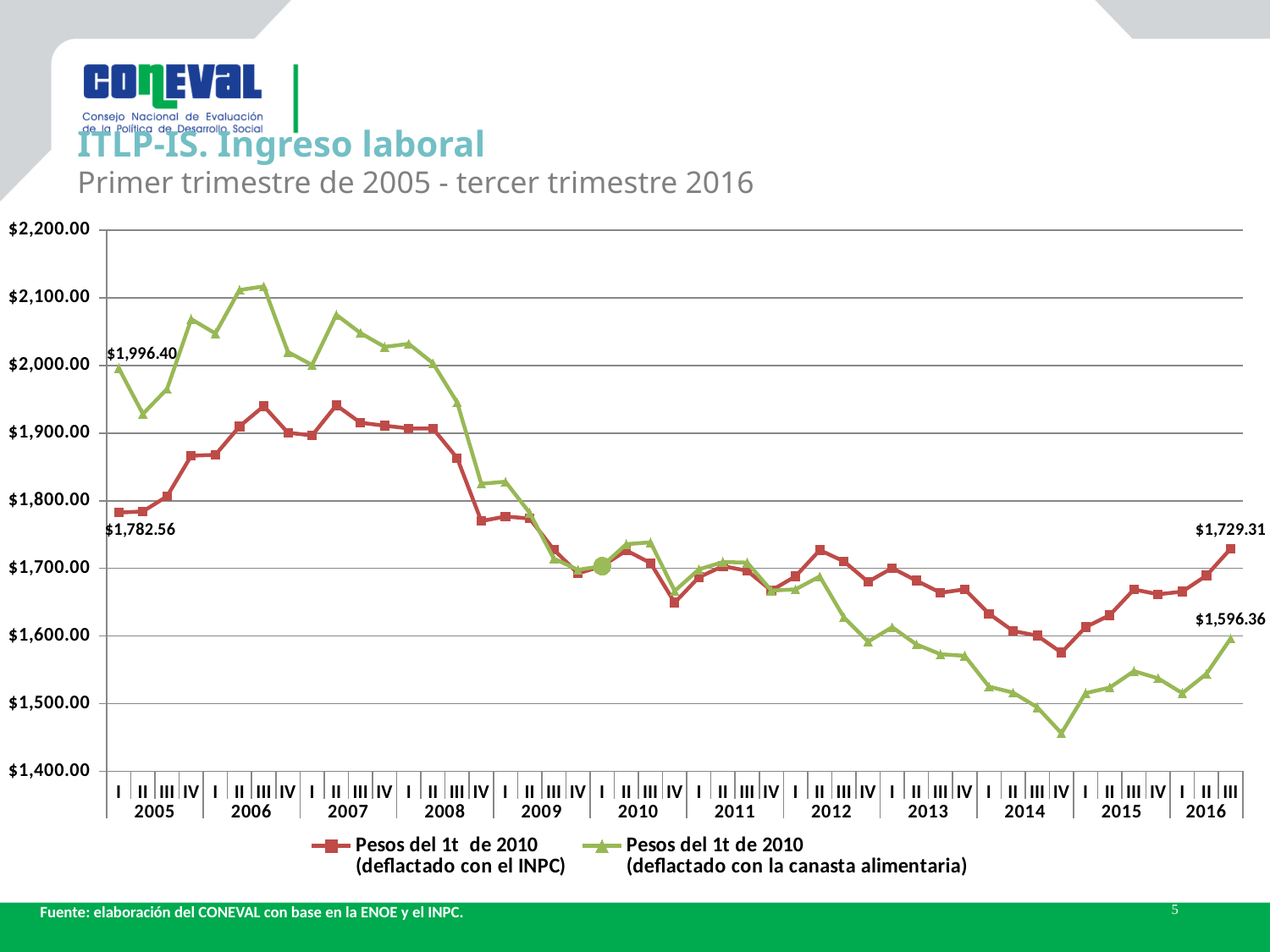
What is the difference between the two series' labelled values in the third quarter of 2016? $132.95 What is the value of the series deflated with the INPC in the third quarter of 2016? $1,729.31 How many series does the legend list? 2 Which series has the higher value in the third quarter of 2016? Pesos del 1t de 2010 (deflactado con el INPC) Is the value of the canasta alimentaria series in the fourth quarter of 2014 greater or less than $1,500.00? less Is the value of the INPC series in the fourth quarter of 2006 greater or less than $2,000.00? less What kind of chart is shown on the slide? line chart What is the value of the 'Pesos del 1t de 2010 (deflactado con el INPC)' series in the first quarter of 2005? $1,782.56 Does the canasta alimentaria series rise or fall overall from the first quarter of 2005 to the third quarter of 2016? fall What is the value of the series deflated with the canasta alimentaria in the third quarter of 2016? $1,596.36 What is the value of the 'Pesos del 1t de 2010 (deflactado con la canasta alimentaria)' series in the first quarter of 2005? $1,996.40 What is the difference between the two series' labelled values in the first quarter of 2005? $213.84